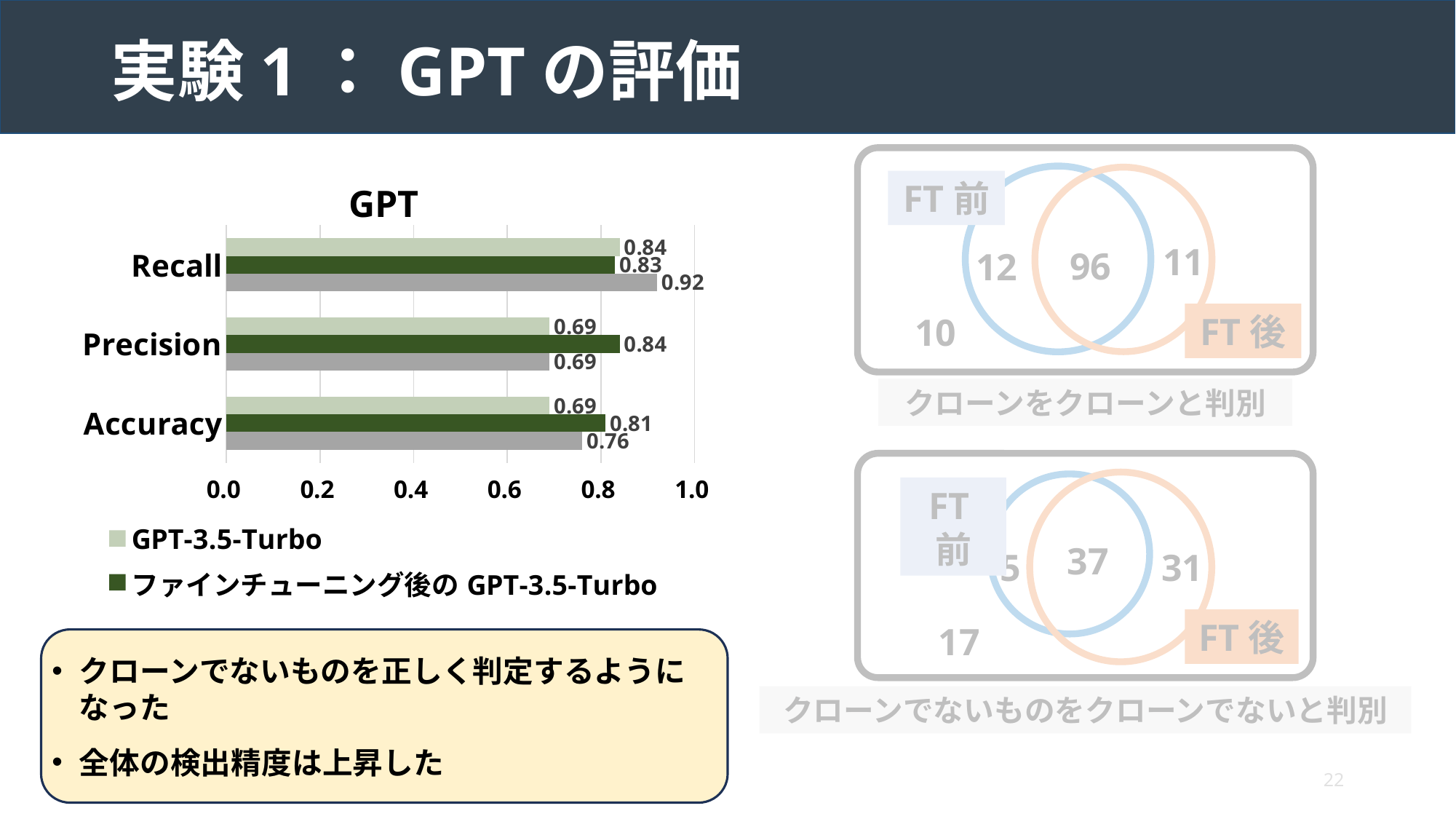
How many metric categories are shown on the y axis of the GPT chart? 3 In the GPT chart, what is the Precision value for GPT-3.5-Turbo? 0.69 How many series does the legend of the GPT chart list? 2 In the GPT chart, which series has the higher Accuracy: GPT-3.5-Turbo or ファインチューニング後の GPT-3.5-Turbo? ファインチューニング後の GPT-3.5-Turbo In the GPT chart, what is the difference in Accuracy between ファインチューニング後の GPT-3.5-Turbo and GPT-3.5-Turbo? 0.12 In the GPT chart, what is the Recall value for GPT-3.5-Turbo? 0.84 In the GPT chart, which metric has the highest value for GPT-3.5-Turbo? Recall In the GPT chart, what is the Precision value for ファインチューニング後の GPT-3.5-Turbo? 0.84 What kind of chart is the GPT chart? Bar chart In the GPT chart, is the Recall value for ファインチューニング後の GPT-3.5-Turbo greater or less than 0.6? greater In the GPT chart, what is the difference in Precision between ファインチューニング後の GPT-3.5-Turbo and GPT-3.5-Turbo? 0.15 In the GPT chart, what is the Accuracy value for ファインチューニング後の GPT-3.5-Turbo? 0.81